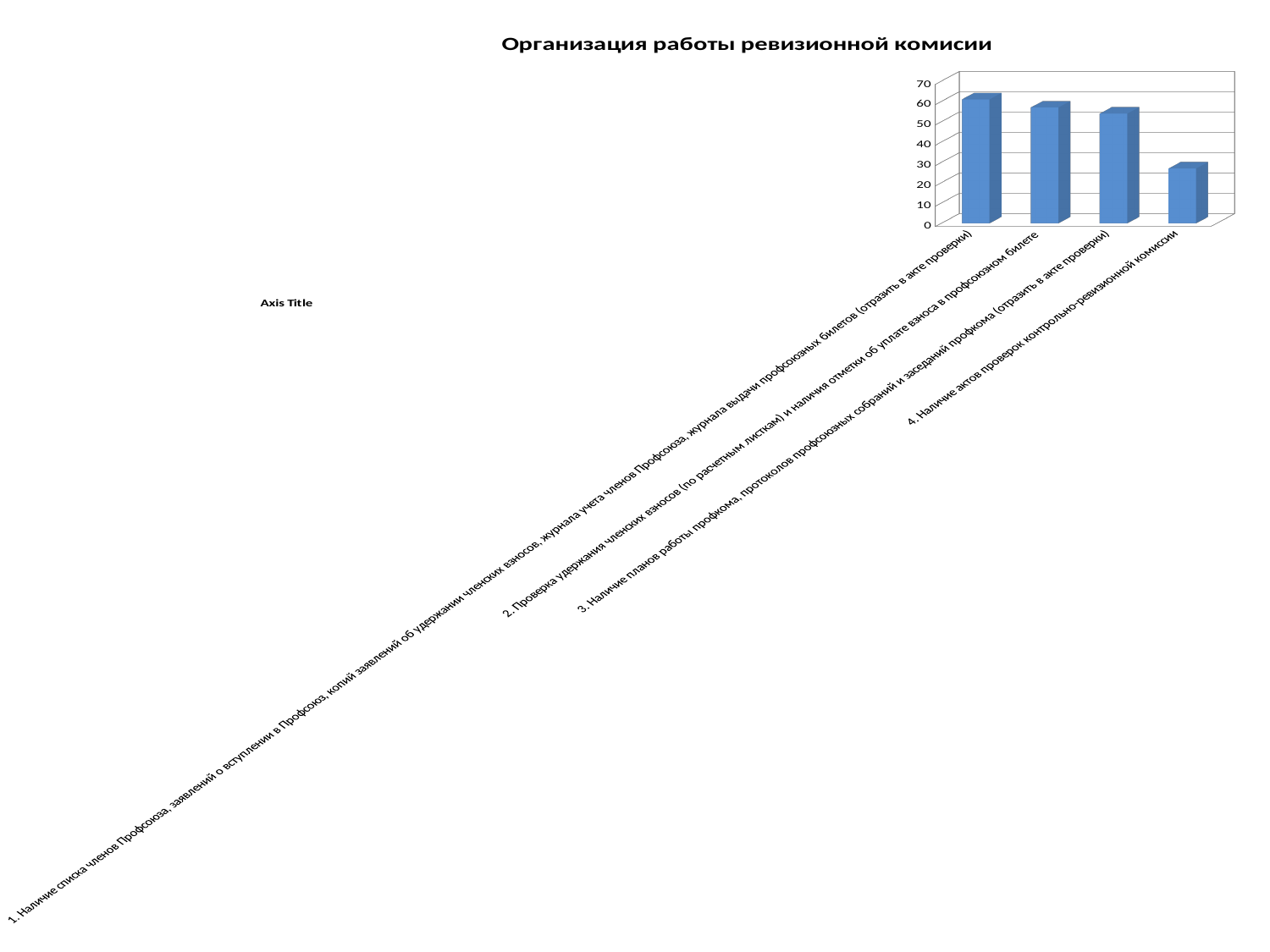
Is the value for category 4 (Наличие актов проверок контрольно-ревизионной комиссии) greater or less than 40? less Is the value for category 2 (Проверка удержания членских взносов...) greater or less than 50? greater Which category has the lowest bar? 4. Наличие актов проверок контрольно-ревизионной комиссии Which is larger: the value for category 1 (Наличие списка членов Профсоюза...) or category 4 (Наличие актов проверок контрольно-ревизионной комиссии)? category 1 (Наличие списка членов Профсоюза...) Is the value for category 1 (Наличие списка членов Профсоюза...) greater or less than 50? greater What is the title of the chart? Организация работы ревизионной комисии What kind of chart is shown on the slide? bar chart How many categories (bars) does the chart show? 4 Do the bar values rise or fall from category 1 to category 4 along the x axis? fall